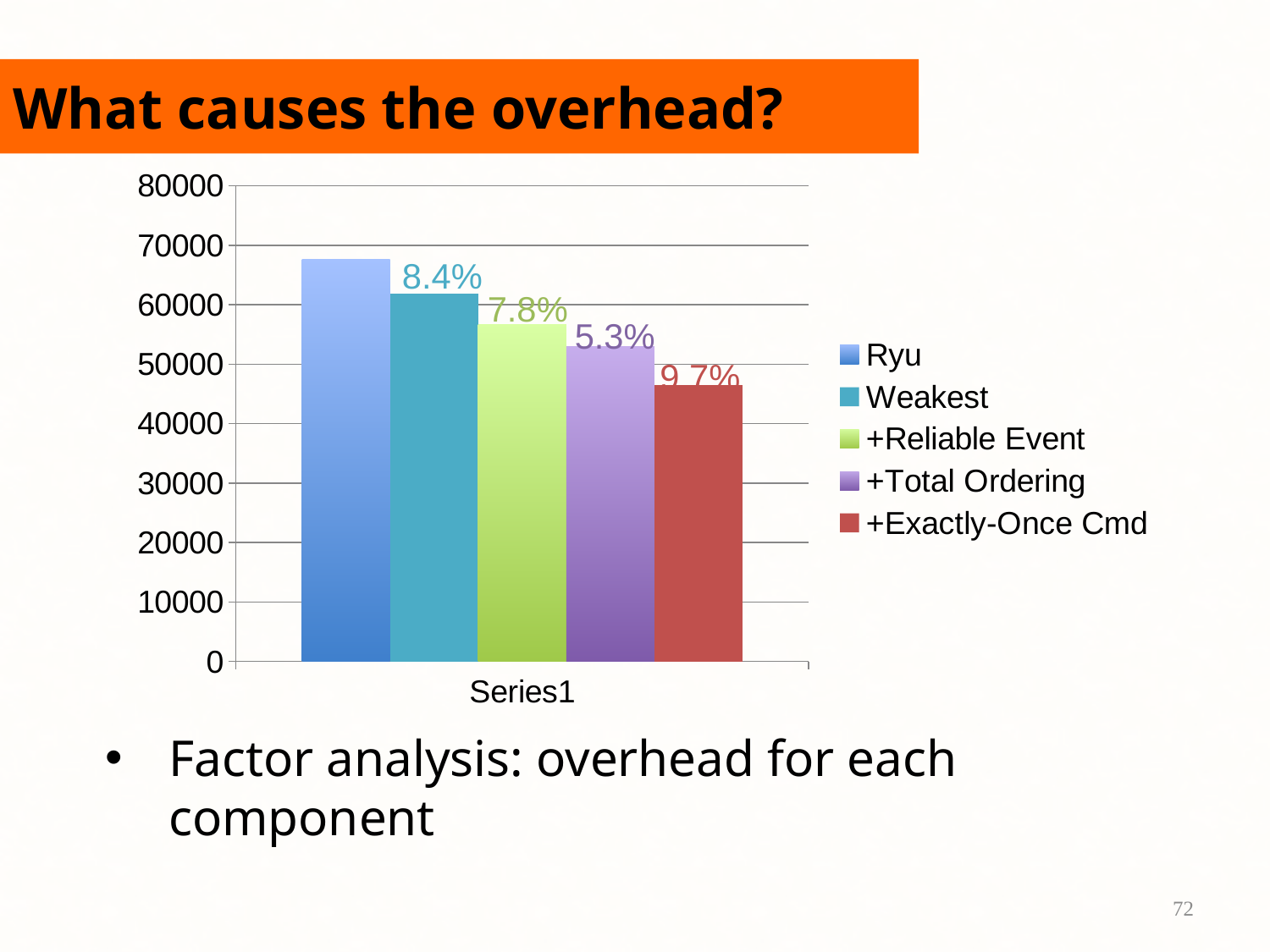
How many series does the legend list? 5 Is the value for +Reliable Event greater or less than 50000? greater What percentage label is printed on the +Exactly-Once Cmd bar? 9.7% What percentage label is printed on the Weakest bar? 8.4% What kind of chart is shown on the slide? bar chart Is the value for Ryu greater or less than 60000? greater What percentage label is printed on the +Total Ordering bar? 5.3% What is the category label shown on the x axis? Series1 Which series has the shortest bar? +Exactly-Once Cmd Is the value for +Exactly-Once Cmd greater or less than 50000? less Which series has the tallest bar? Ryu Which is larger, the bar for Weakest or the bar for +Reliable Event? Weakest